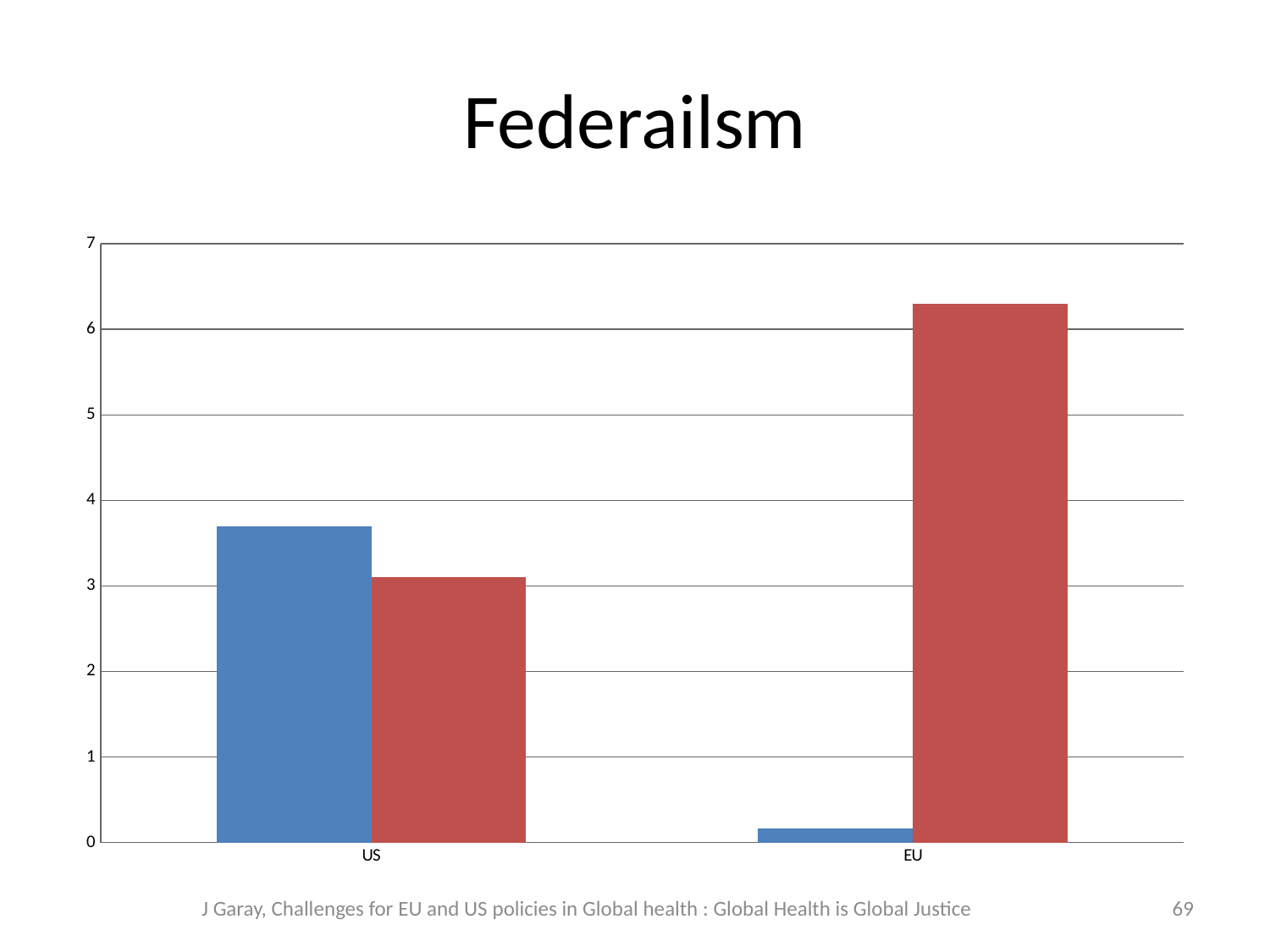
Which category has the taller blue bar, US or EU? US Is the value of the blue bar for EU greater or less than 1? less Is the value of the red bar for EU greater or less than 6? greater Is the value of the red bar for US greater or less than 4? less What is the title of the chart on the slide? Federailsm Which category has the taller red bar, US or EU? EU Which bar is the tallest in the chart? the red bar for EU How many categories are shown on the x axis of the chart? 2 What kind of chart is shown on the slide? bar chart Which categories are shown on the x axis of the chart? US and EU